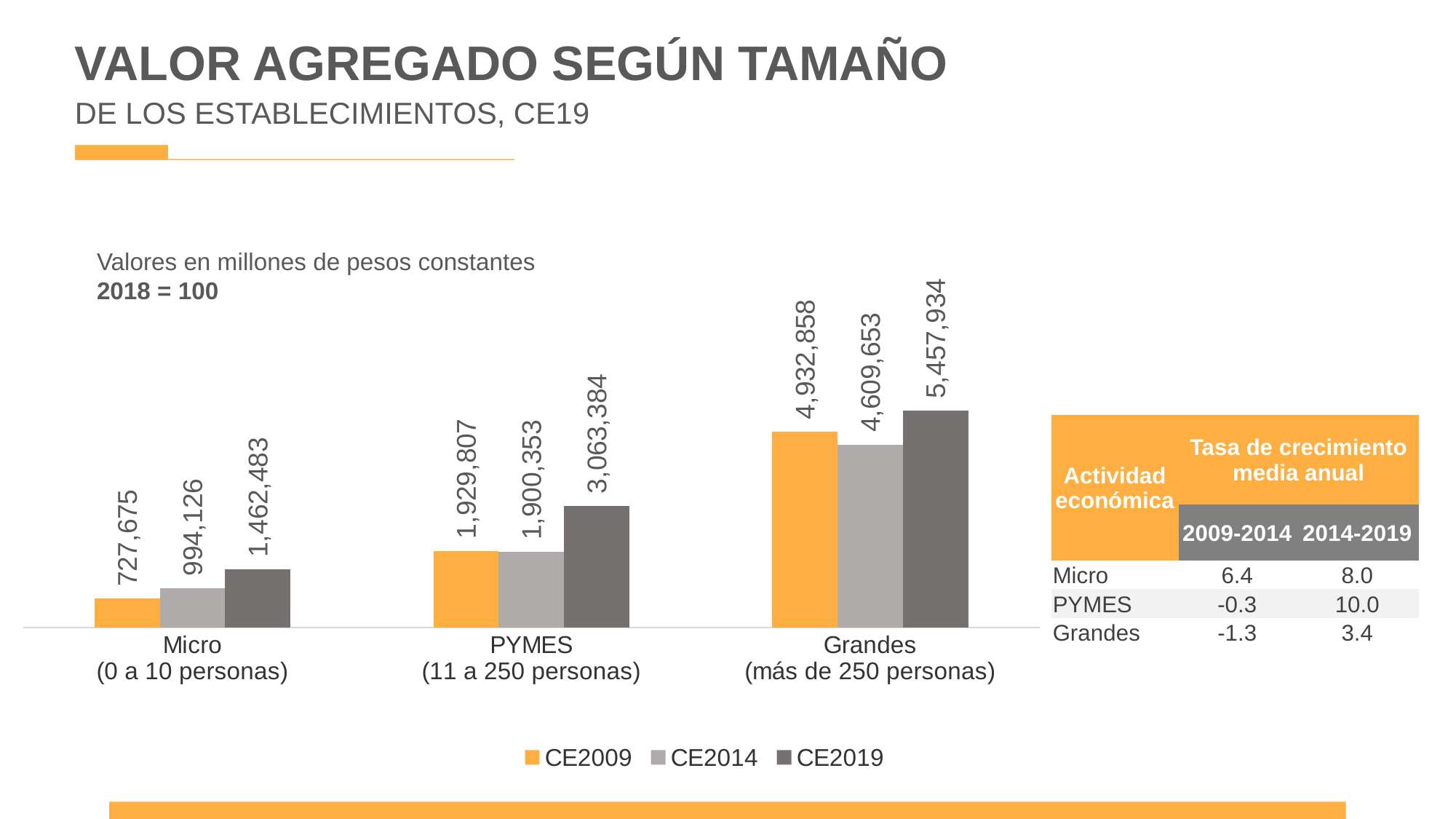
Which series is shown in orange in the chart? CE2009 What kind of chart is shown on the slide? Bar chart Which category has the lowest value in the CE2009 series? Micro (0 a 10 personas) For Grandes (más de 250 personas), which is larger: the CE2009 value or the CE2014 value? CE2009 How many categories are shown on the x axis of the chart? 3 What is the difference between the CE2019 and CE2009 values for Micro (0 a 10 personas)? 734,808 What is the value for Micro (0 a 10 personas) in the CE2009 series? 727,675 What is the value for Grandes (más de 250 personas) in the CE2014 series? 4,609,653 Which category has the highest value in the CE2019 series? Grandes (más de 250 personas) What is the difference between the CE2019 and CE2014 values for Grandes (más de 250 personas)? 848,281 How many series does the legend list? 3 What is the value for PYMES (11 a 250 personas) in the CE2019 series? 3,063,384